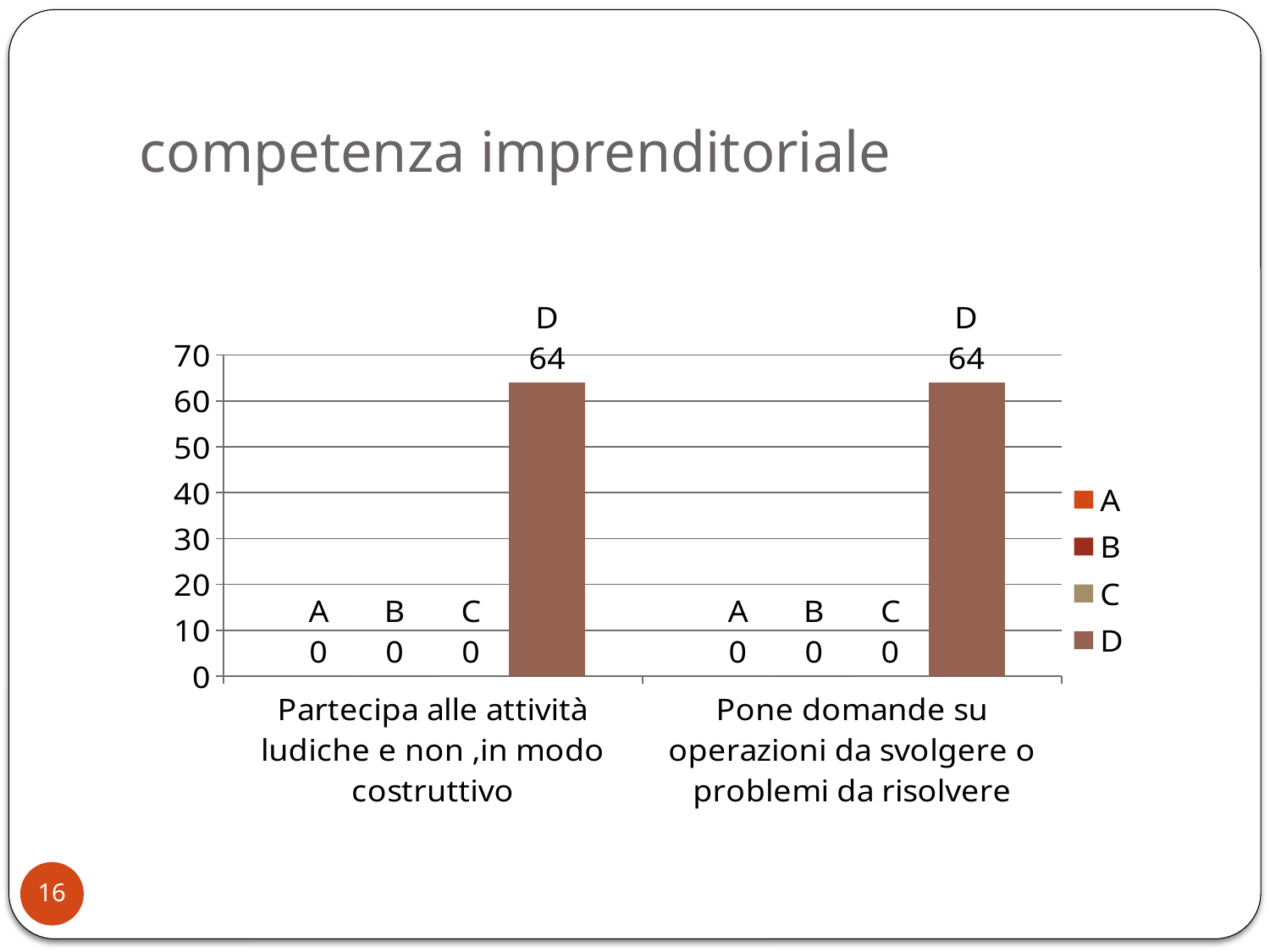
What kind of chart is shown on the slide? bar chart What is the highest value shown on the y axis of the chart? 70 What is the value of series D for the category "Partecipa alle attività ludiche e non ,in modo costruttivo"? 64 What is the value of series D for the category "Pone domande su operazioni da svolgere o problemi da risolvere"? 64 What is the difference between the values of series D and series B for the category "Pone domande su operazioni da svolgere o problemi da risolvere"? 64 Which series has the highest value for the category "Partecipa alle attività ludiche e non ,in modo costruttivo"? D What is the value of series A for the category "Partecipa alle attività ludiche e non ,in modo costruttivo"? 0 How many categories are shown on the x axis of the chart? 2 What is the title of the slide containing the chart? competenza imprenditoriale How many series does the legend list? 4 Is the value of series D for "Partecipa alle attività ludiche e non ,in modo costruttivo" greater or less than 60? greater What is the value of series C for the category "Pone domande su operazioni da svolgere o problemi da risolvere"? 0